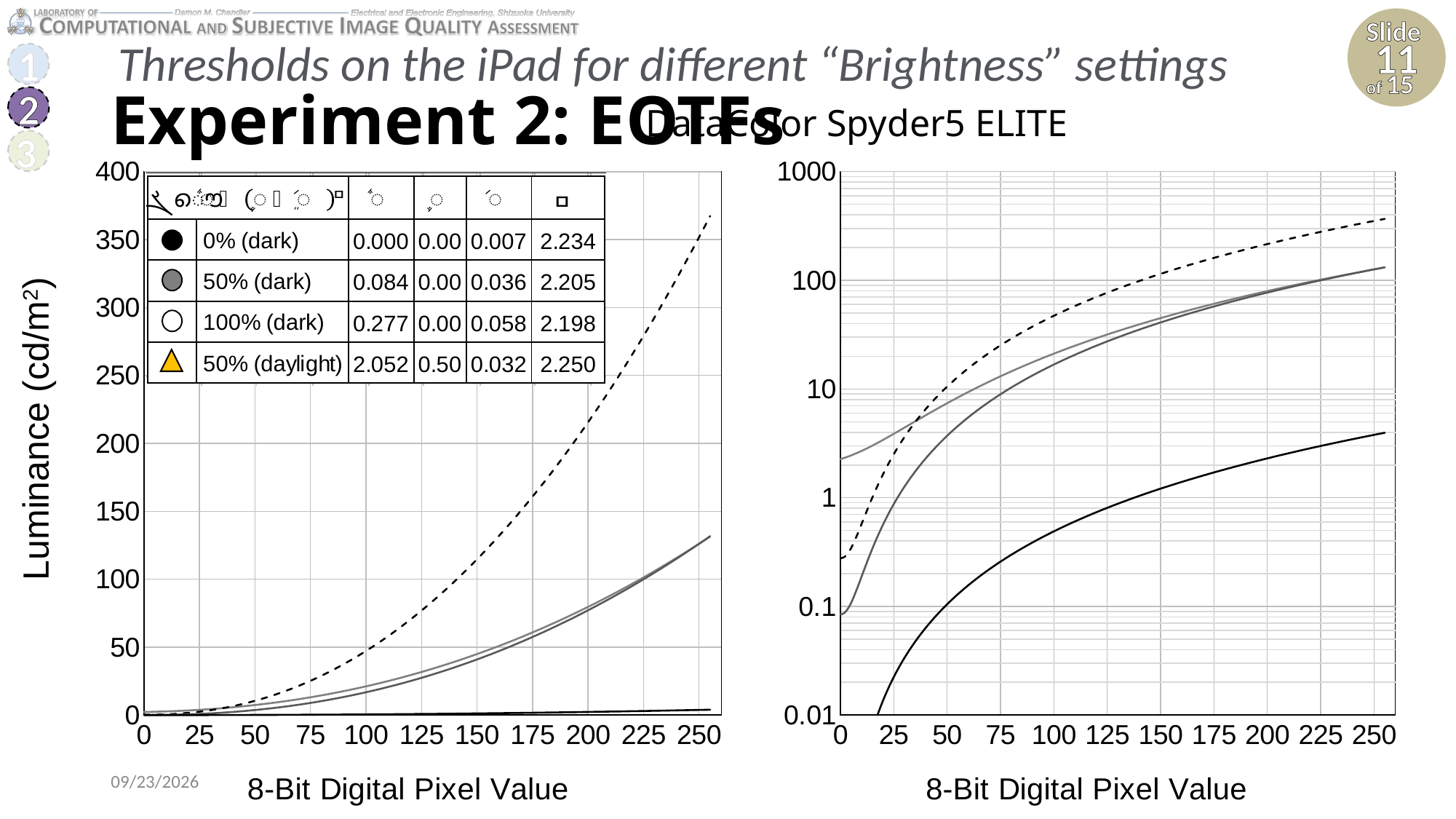
What is the highest tick value shown on the y axis of the right chart? 1000 On the right chart, is the value of the black solid line at pixel value 250 greater or less than 10? less In the legend table on the left chart, what value is printed in the last column for the 50% (daylight) entry? 2.250 On the left chart, is the value of the dashed line at pixel value 250 greater or less than 300? greater What is the x-axis label of the left chart? 8-Bit Digital Pixel Value On the left chart, at pixel value 250, which is higher: the dashed line or the black solid line? the dashed line What kind of chart is the left chart on the slide? line chart On the left chart, is the value of the black solid line at pixel value 250 greater or less than 50? less What is the y-axis label of the left chart? Luminance (cd/m²) On the left chart, do the luminance values rise or fall as the pixel value increases? rise How many entries does the legend table on the left chart list? 4